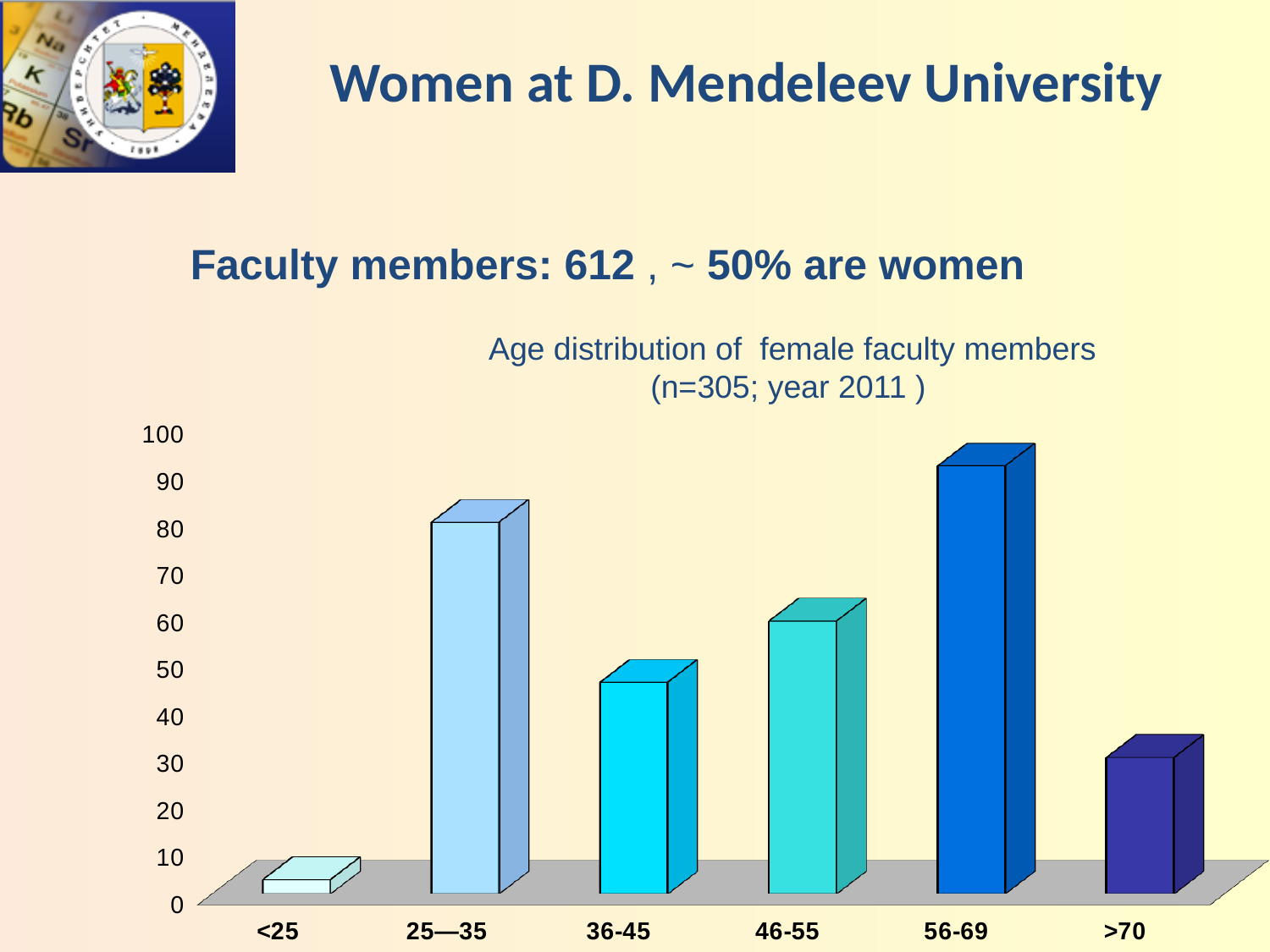
What kind of chart is shown on the slide? bar chart Which age group has the lowest number of female faculty members? <25 Which age group has a larger value, 25—35 or 46-55? 25—35 Which age group has the highest number of female faculty members? 56-69 How many age categories are shown on the x axis of the chart? 6 Is the value for the 56-69 age group greater or less than 80? greater Is the value for the <25 age group greater or less than 10? less Is the value for the 25—35 age group greater or less than 70? greater What is the title of the chart? Age distribution of female faculty members (n=305; year 2011 )